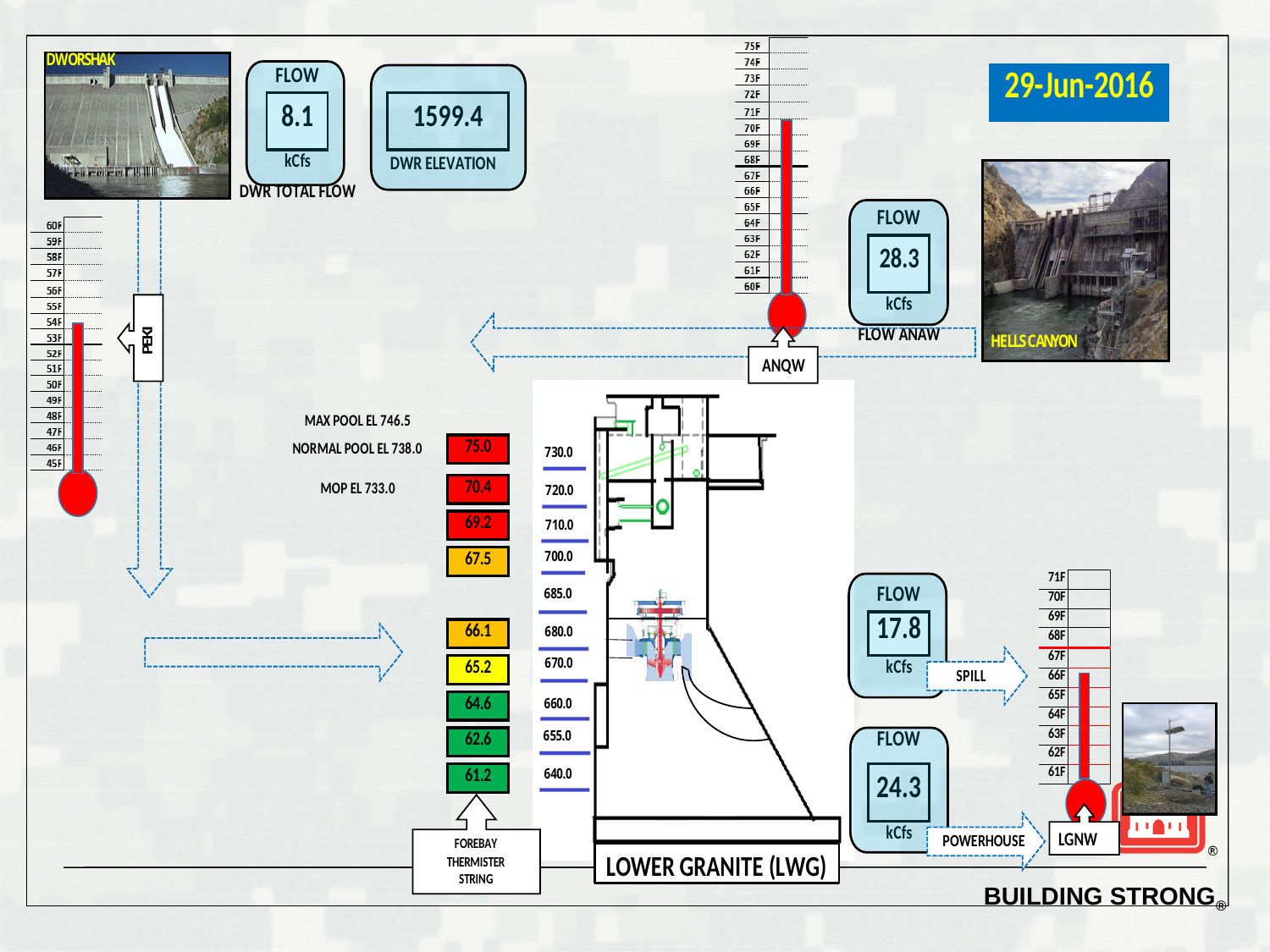
How many temperature values are listed in the forebay thermistor string? 9 What is the flow value shown for ANAW (Hells Canyon)? 28.3 kCfs What is the powerhouse flow value shown for Lower Granite? 24.3 kCfs What is the difference between the powerhouse flow (24.3) and the spill flow (17.8) at Lower Granite? 6.5 kCfs What is the spill flow value shown for Lower Granite? 17.8 kCfs What is the DWR elevation shown on the slide? 1599.4 What is the DWR total flow value shown on the slide? 8.1 kCfs Is the reading on the ANQW thermometer greater or less than 65F? greater Is the reading on the PEKI thermometer greater or less than 55F? less Which is larger at Lower Granite, the spill flow or the powerhouse flow? Powerhouse flow What is the highest temperature value in the forebay thermistor string? 75.0 What is the lowest temperature value in the forebay thermistor string? 61.2